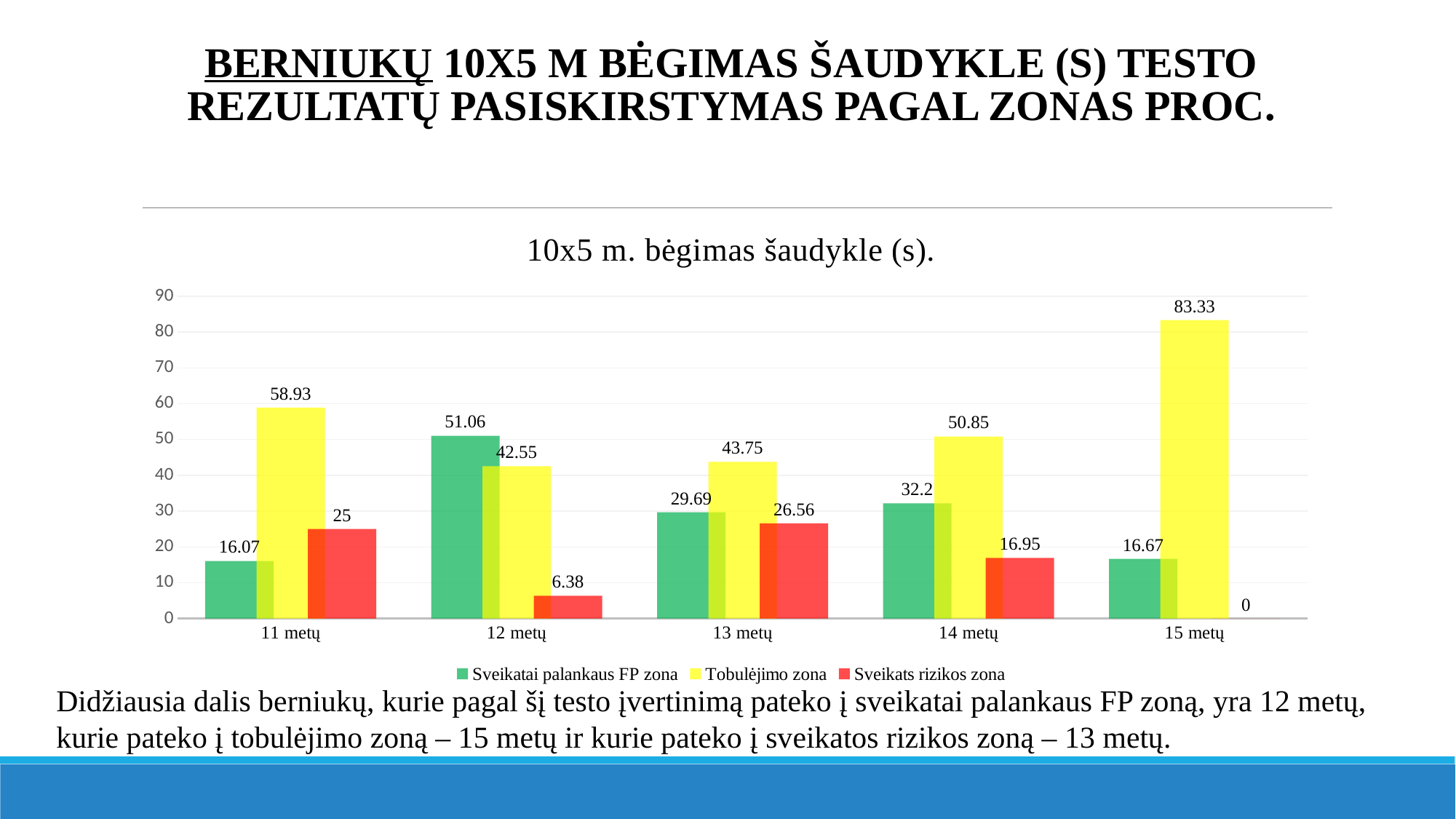
How many age groups are shown on the x axis? 5 What colour represents Tobulėjimo zona in the chart? Yellow What kind of chart is shown on the slide? Bar chart What is the title of the chart? 10x5 m. bėgimas šaudykle (s). Which is larger for 14 metų: Sveikatai palankaus FP zona or Sveikats rizikos zona? Sveikatai palankaus FP zona How many series does the legend list? 3 What is the value of Sveikatai palankaus FP zona for 12 metų? 51.06 What is the value of Tobulėjimo zona for 15 metų? 83.33 What is the difference between the Tobulėjimo zona values for 15 metų and 11 metų? 24.4 What is the value of Sveikats rizikos zona for 13 metų? 26.56 Which age group has the lowest value for Tobulėjimo zona? 12 metų Which age group has the highest value for Sveikats rizikos zona? 13 metų